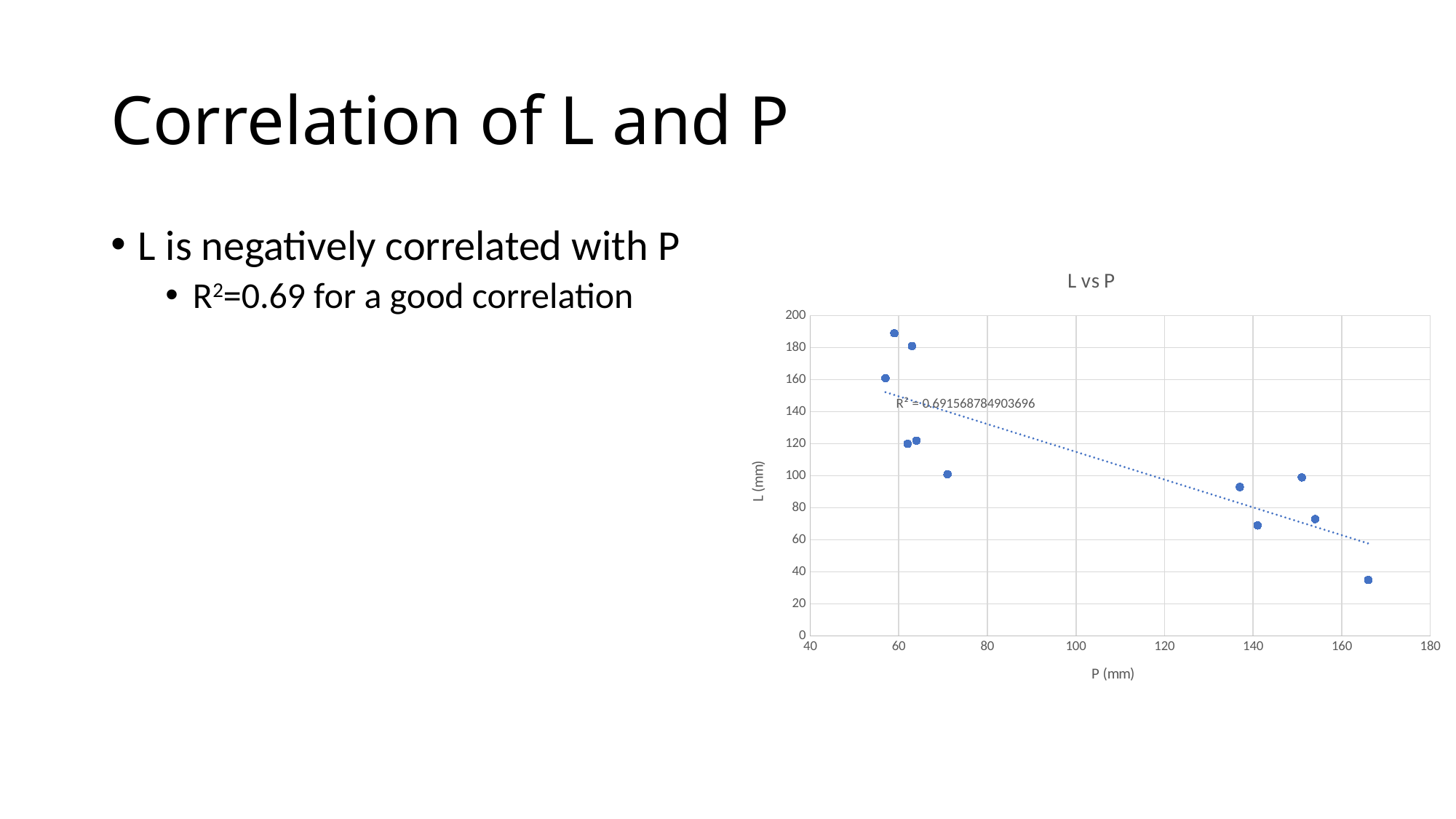
Is the highest L value plotted in the chart greater or less than 180? greater Which has the larger L value: the point near P = 166 mm or the point near P = 151 mm? the point near P = 151 mm Is the L value of the point with the largest P (near 166 mm) greater or less than 60? less What is the title of the chart? L vs P What kind of chart is shown on the slide? scatter chart What is the label of the x axis of the chart? P (mm) Is the lowest L value plotted in the chart greater or less than 60? less What R² value is printed on the chart's trendline? 0.691568784903696 How many data points are plotted in the L vs P chart? 11 As P increases along the x axis, do the L values generally rise or fall? fall